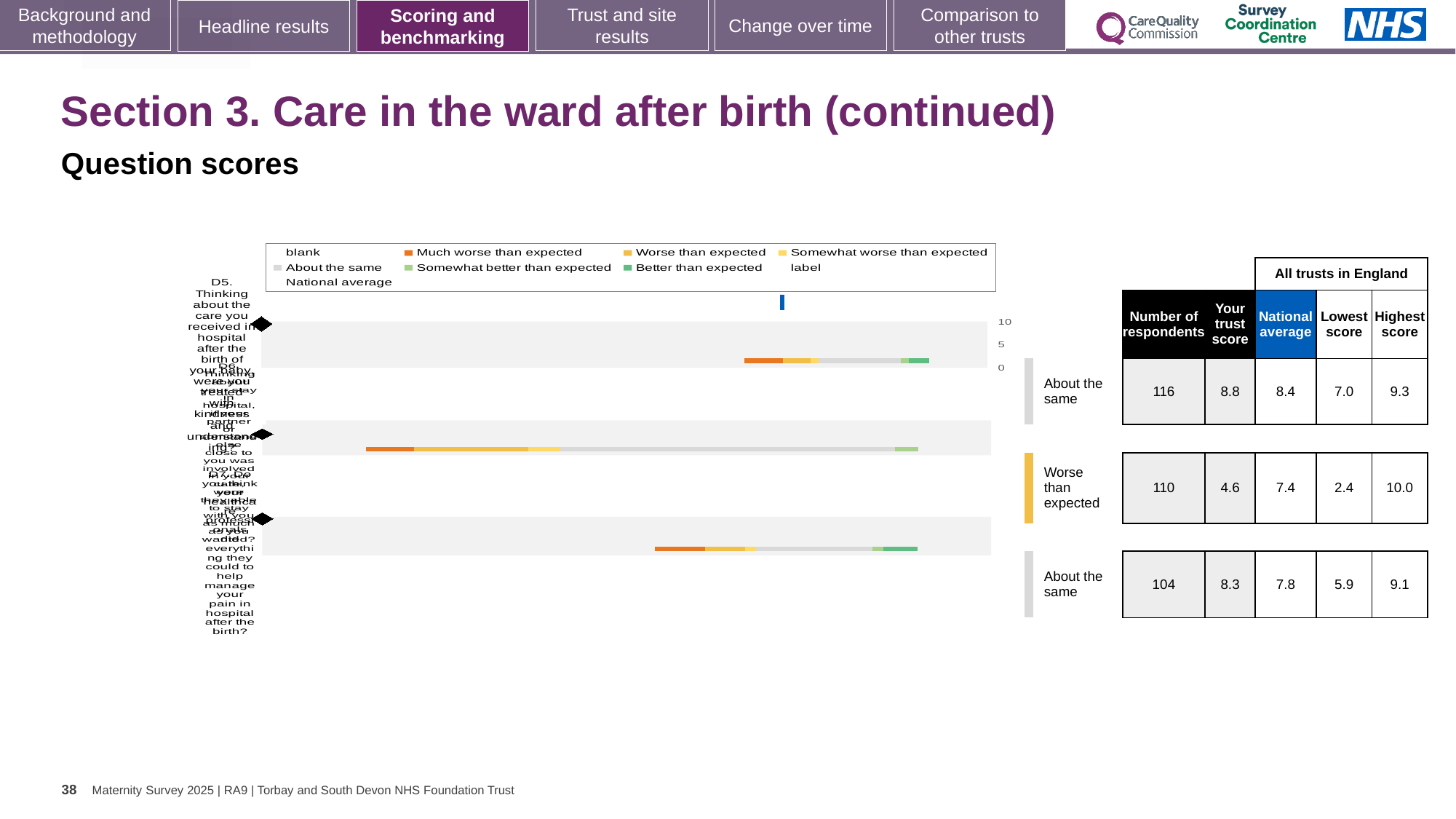
What colour does the legend use for 'Much worse than expected'? orange What benchmark label is shown to the right of the middle bar? Worse than expected How many horizontal bars (question rows) does the chart contain? 3 Which of the three bars has the widest coloured band: the top, middle or bottom bar? middle bar In the table beside the chart, what is the 'Your trust score' for the row labelled 'Worse than expected'? 4.6 Which row has the lowest 'Your trust score' in the table beside the chart: top, middle or bottom? middle In the table beside the chart, what is the highest score for the middle row? 10.0 In the table beside the chart, what is the number of respondents for the top row? 116 What kind of chart is shown on the slide? bar chart What colour does the legend use for 'Better than expected'? green Is the trust score for the bottom row (8.3) greater or less than its national average (7.8)? greater For the middle row, what is the difference between the national average (7.4) and the trust score (4.6)? 2.8